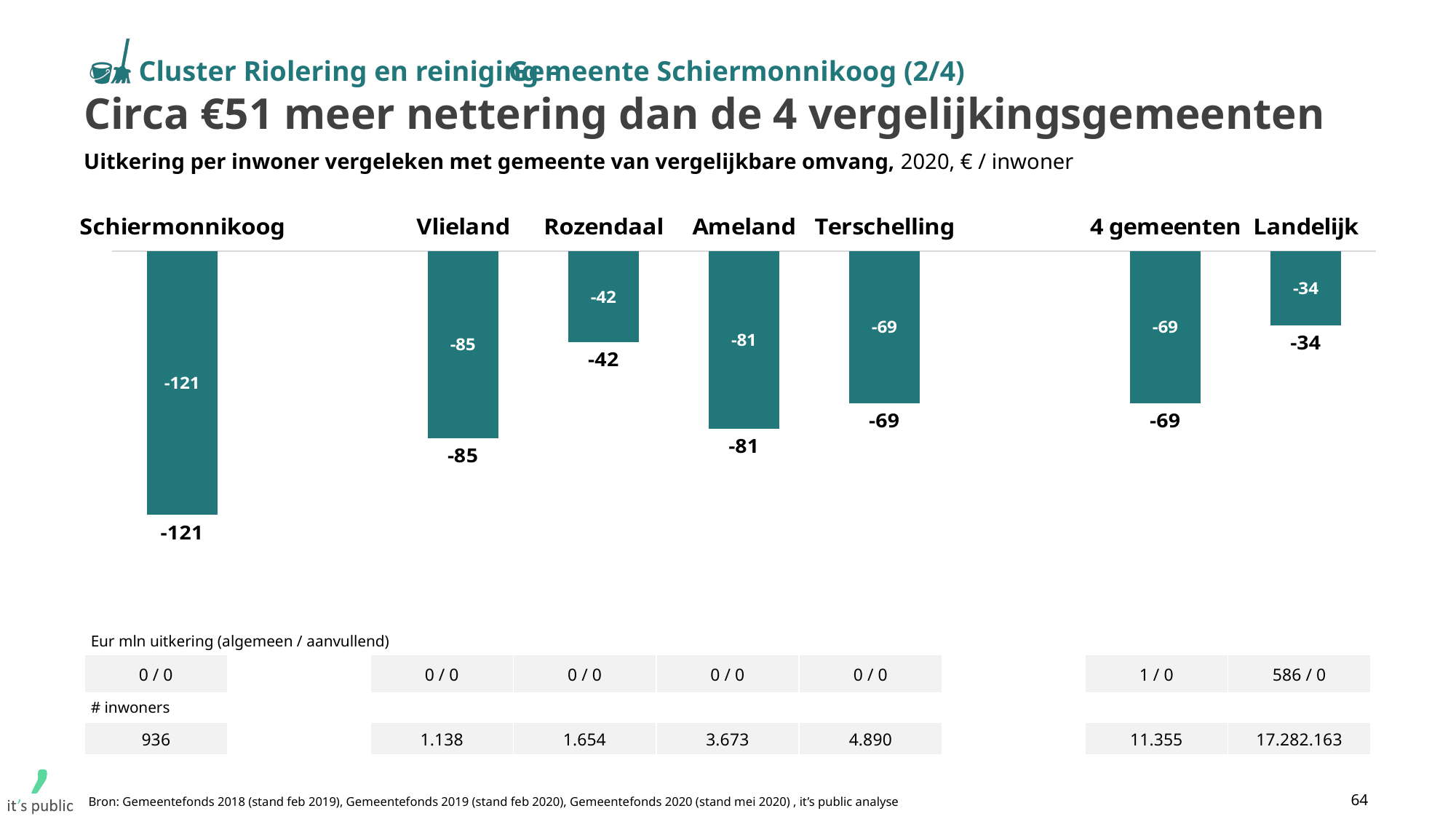
What kind of chart is shown on the slide? Bar chart What is the value for Rozendaal? -42 What is the value for Vlieland? -85 Which category has the highest (least negative) value? Landelijk What is the difference between the values for Vlieland and Rozendaal? 43 What is the value for Schiermonnikoog? -121 Which has the larger (less negative) value, Ameland or Terschelling? Terschelling What is the value for 4 gemeenten? -69 What is the difference between the values for Ameland and Terschelling? 12 How many bars are shown in the chart? 7 What is the value for Landelijk? -34 Which category has the lowest (most negative) value? Schiermonnikoog